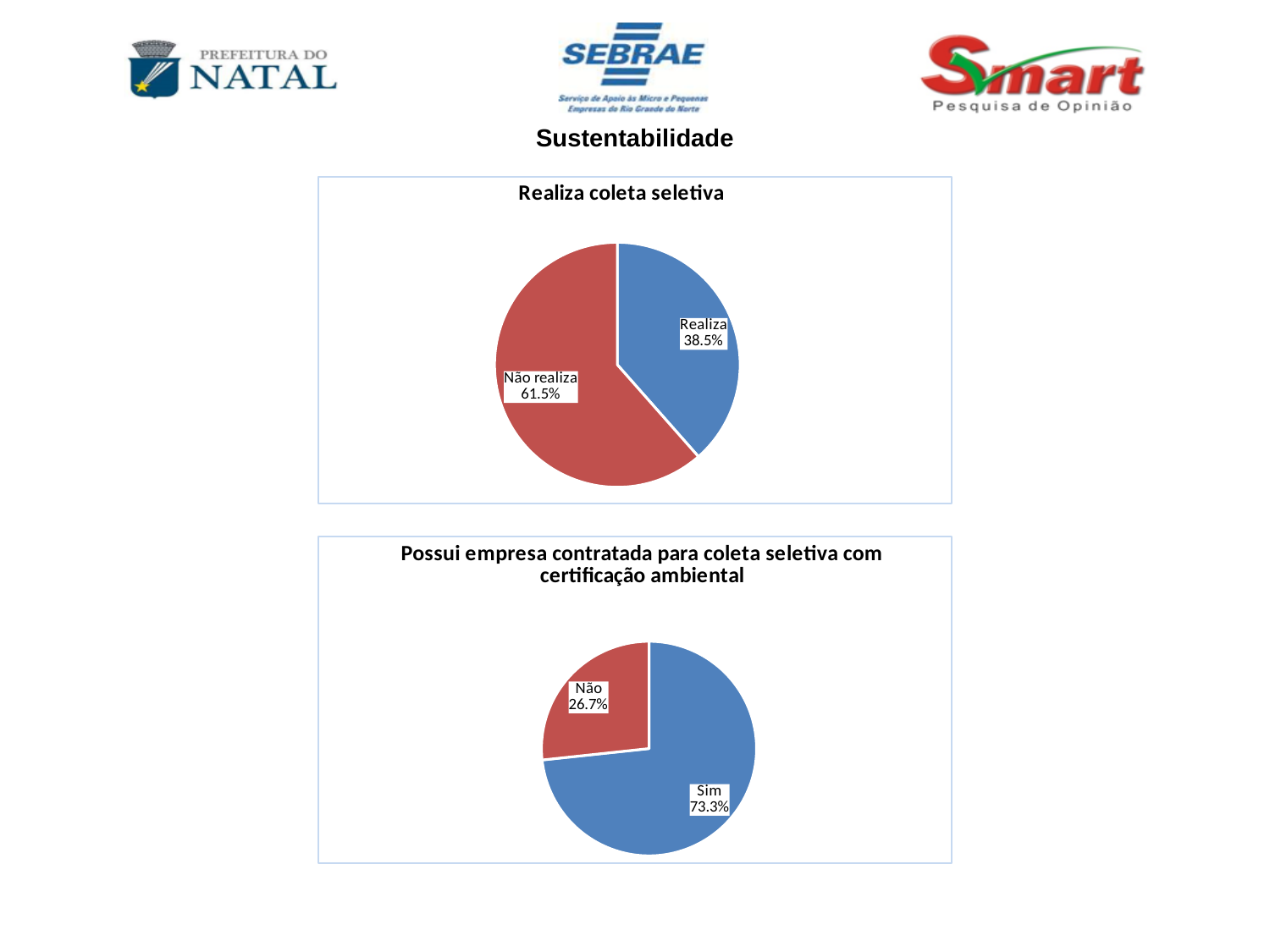
In the 'Realiza coleta seletiva' chart, what is the difference in percentage points between 'Não realiza' and 'Realiza'? 23.0 percentage points In the 'Possui empresa contratada para coleta seletiva com certificação ambiental' chart, is the 'Sim' slice larger or smaller than the 'Não' slice? Larger In the 'Possui empresa contratada para coleta seletiva com certificação ambiental' chart, what share answered 'Não'? 26.7% What type of chart is the 'Realiza coleta seletiva' chart? Pie chart In the 'Possui empresa contratada para coleta seletiva com certificação ambiental' chart, what share answered 'Sim'? 73.3% In the 'Realiza coleta seletiva' chart, what colour is the 'Não realiza' slice? Red In the 'Realiza coleta seletiva' chart, what share of respondents answered 'Não realiza'? 61.5% In the 'Realiza coleta seletiva' chart, which category has the largest slice? Não realiza In the 'Realiza coleta seletiva' chart, what share of respondents answered 'Realiza'? 38.5% In the 'Realiza coleta seletiva' chart, how many slices does the pie have? 2 In the 'Possui empresa contratada para coleta seletiva com certificação ambiental' chart, what is the difference in percentage points between 'Sim' and 'Não'? 46.6 percentage points In the 'Possui empresa contratada para coleta seletiva com certificação ambiental' chart, which category has the smallest slice? Não